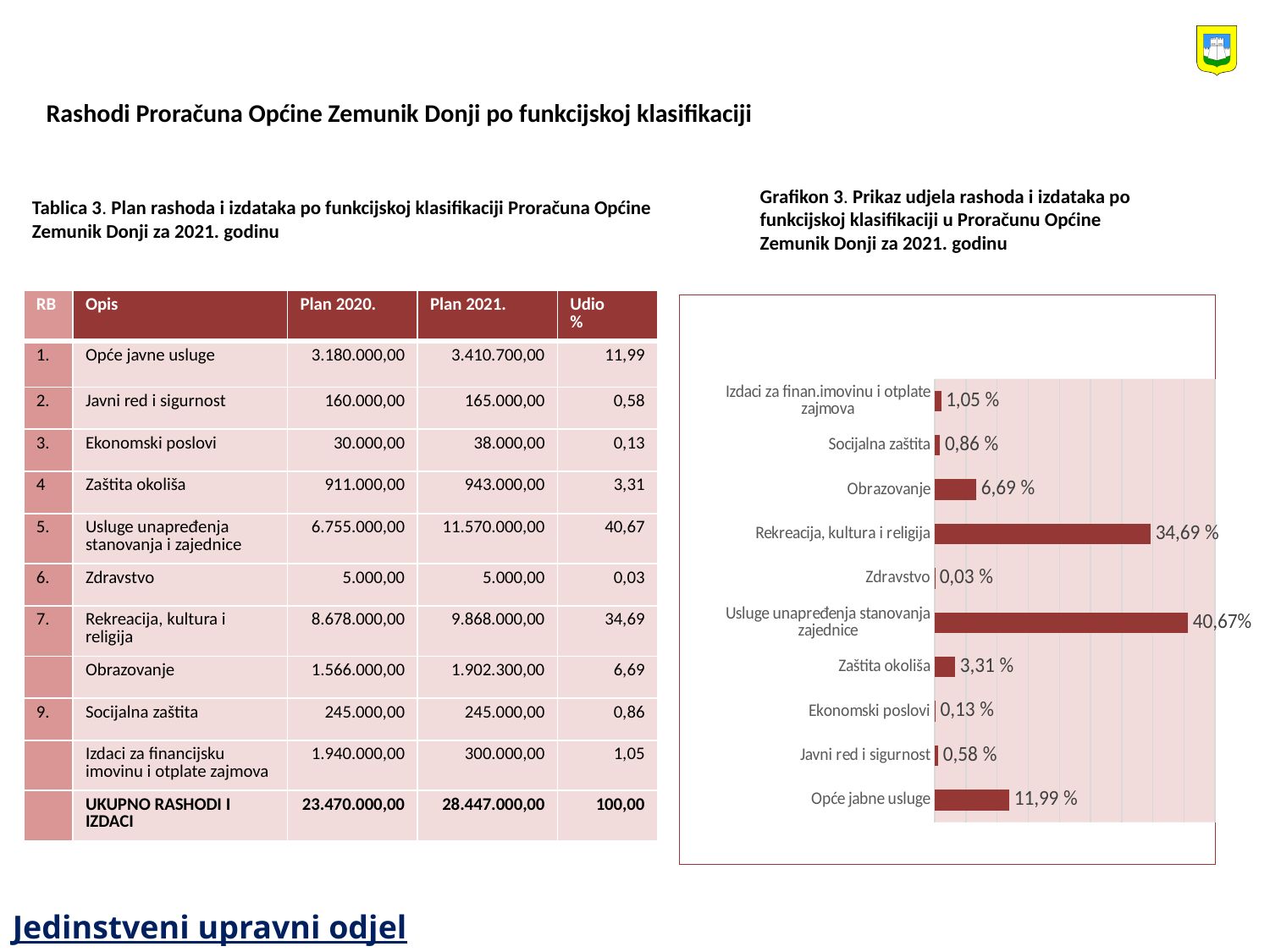
What is the value for Socijalna zaštita in the chart? 0,86 % What is the difference between the values for Usluge unapređenja stanovanja zajednice and Rekreacija, kultura i religija? 5,98 % What is the value for Zaštita okoliša in the chart? 3,31 % What kind of chart is shown on the slide? bar chart How many categories does the chart show? 10 Which category has the lowest value in the chart? Zdravstvo What is the title of the chart? Grafikon 3. Prikaz udjela rashoda i izdataka po funkcijskoj klasifikaciji u Proračunu Općine Zemunik Donji za 2021. godinu What is the value for Rekreacija, kultura i religija in the chart? 34,69 % What is the value for Obrazovanje in the chart? 6,69 % Which is larger, the value for Obrazovanje or the value for Zaštita okoliša? Obrazovanje Which category has the highest value in the chart? Usluge unapređenja stanovanja zajednice What is the value for Opće jabne usluge in the chart? 11,99 %